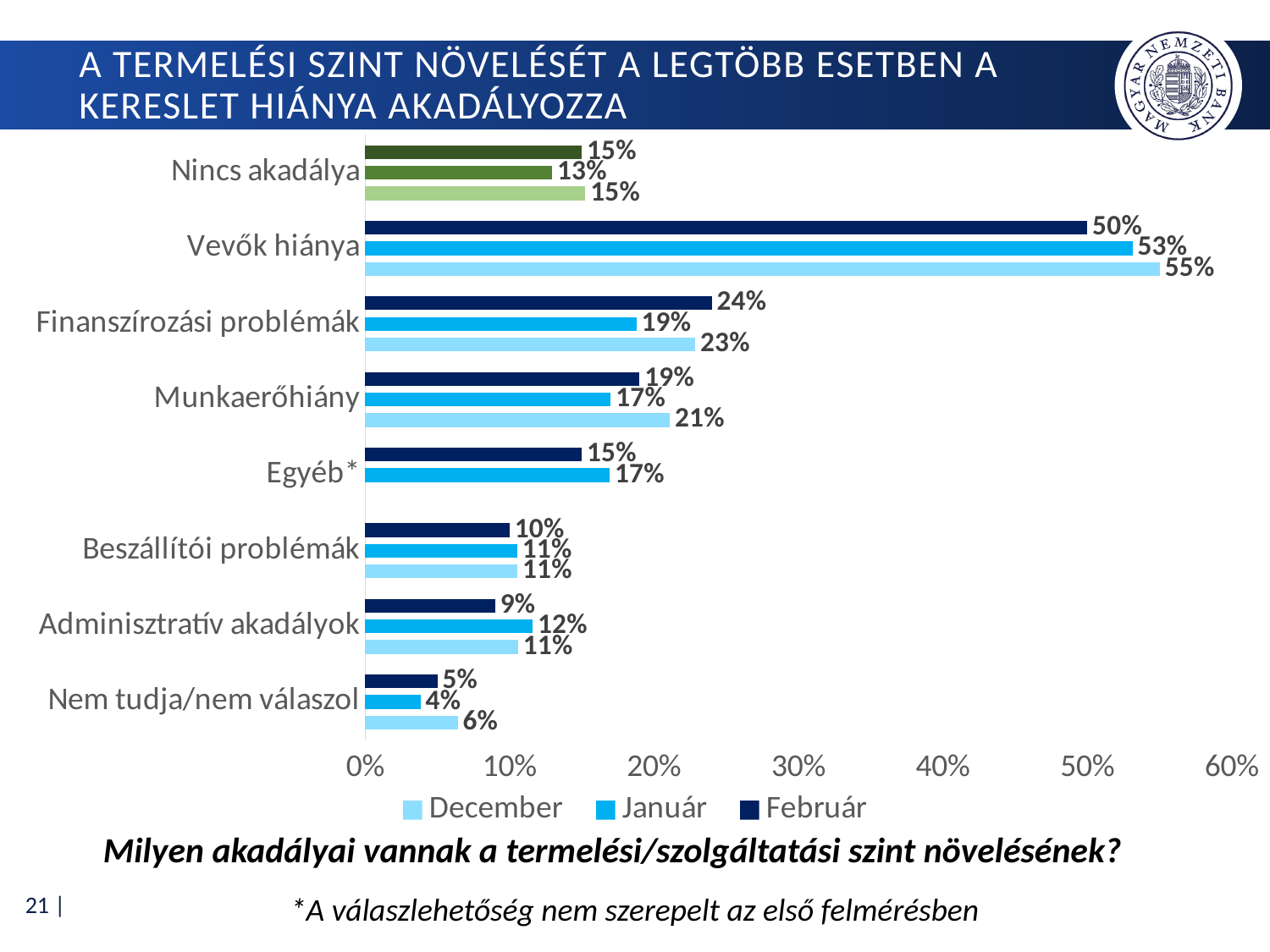
What is the December value for Vevők hiánya? 55% Is the Január value for Vevők hiánya greater or less than 50%? greater What is the Január value for Munkaerőhiány? 17% Which category has no December bar? Egyéb* What kind of chart is shown on the slide? bar chart How many series does the legend list? 3 How many categories are shown on the chart? 8 Which is larger for Adminisztratív akadályok: the Január value or the Február value? Január What is the difference between the December and Február values for Vevők hiánya? 5% Which category has the lowest December value? Nem tudja/nem válaszol What is the Február value for Finanszírozási problémák? 24% Which category has the highest Február value? Vevők hiánya